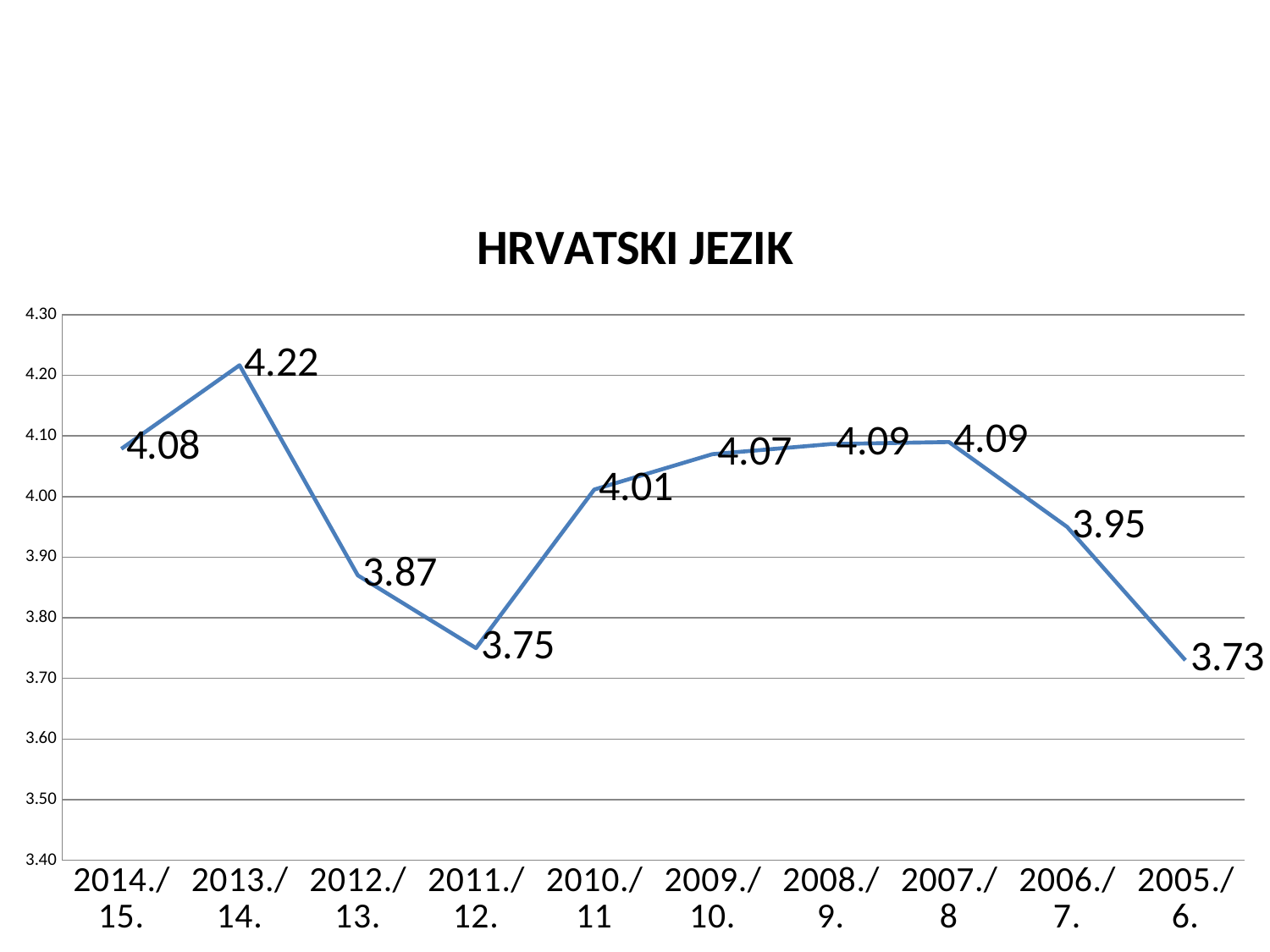
What is the value for 2011./12.? 3.75 What kind of chart is shown? line chart What is the title of the chart? HRVATSKI JEZIK What is the difference between the values for 2014./15. and 2012./13.? 0.21 What is the value for 2013./14.? 4.22 What is the value for 2005./6.? 3.73 What is the difference between the values for 2013./14. and 2011./12.? 0.47 Which is larger, the value for 2010./11 or the value for 2006./7.? 2010./11 Which school year has the highest value? 2013./14. How many school years are plotted on the chart? 10 Is the value for 2009./10. greater or less than 4.00? greater Which school year has the lowest value? 2005./6.